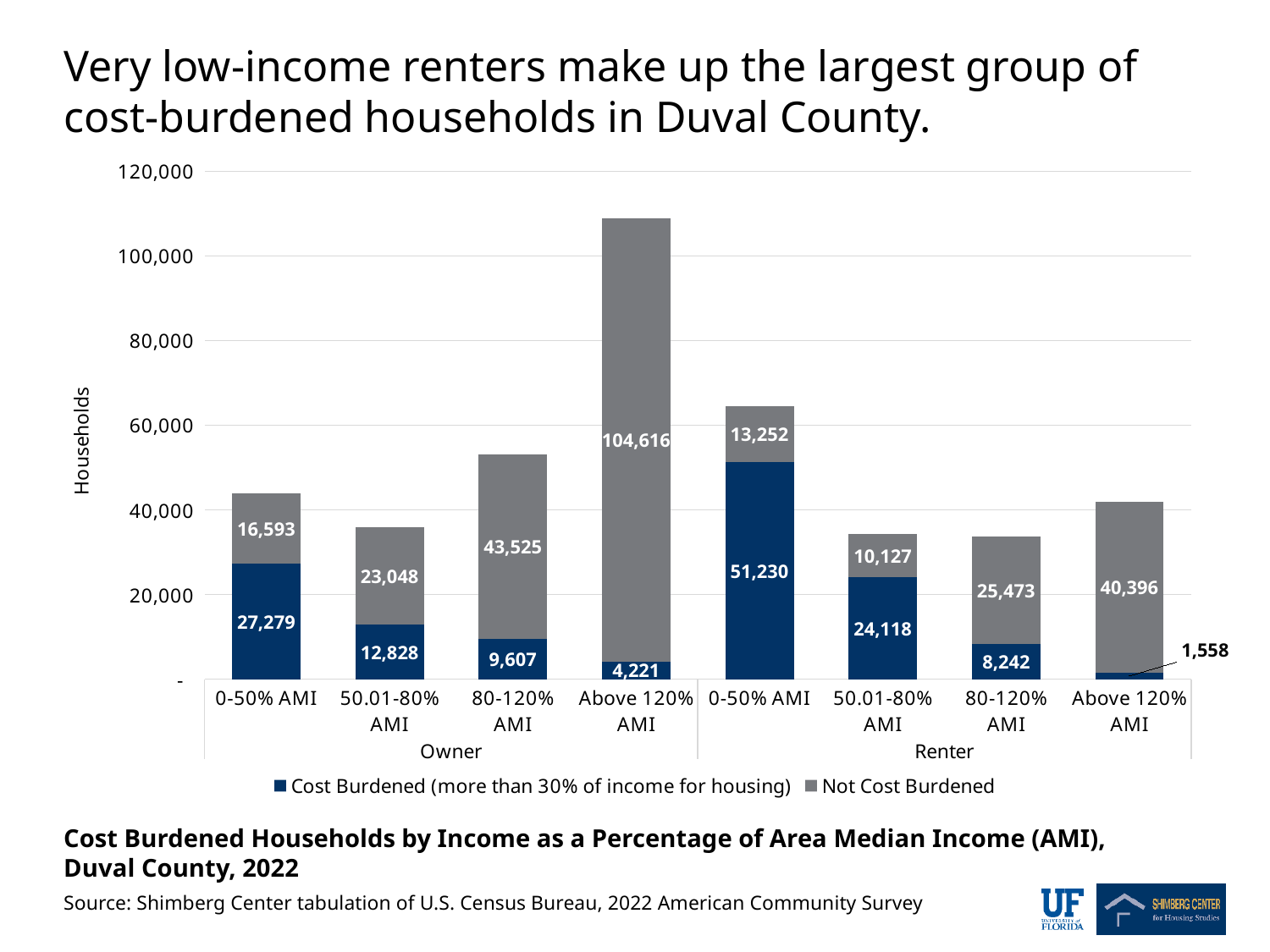
Which category has the smallest number of cost-burdened households? Renter Above 120% AMI Which is larger: the number of not cost-burdened renter households at 80-120% AMI or the number of not cost-burdened owner households at 50.01-80% AMI? Not cost-burdened renter households at 80-120% AMI What is the number of cost-burdened owner households with income 50.01-80% AMI? 12,828 Which category has the largest number of cost-burdened households? Renter 0-50% AMI How many series does the legend list? 2 What is the difference between cost-burdened renter households at 0-50% AMI and cost-burdened owner households at 0-50% AMI? 23,951 What kind of chart is shown on the slide? Stacked bar chart What is the number of not cost-burdened owner households with income above 120% AMI? 104,616 What is the number of cost-burdened renter households with income 0-50% AMI? 51,230 What is the total number of households in the Owner 0-50% AMI bar? 43,872 How many income categories are shown on the x axis in total? 8 What is the total number of households in the Renter 0-50% AMI bar? 64,482